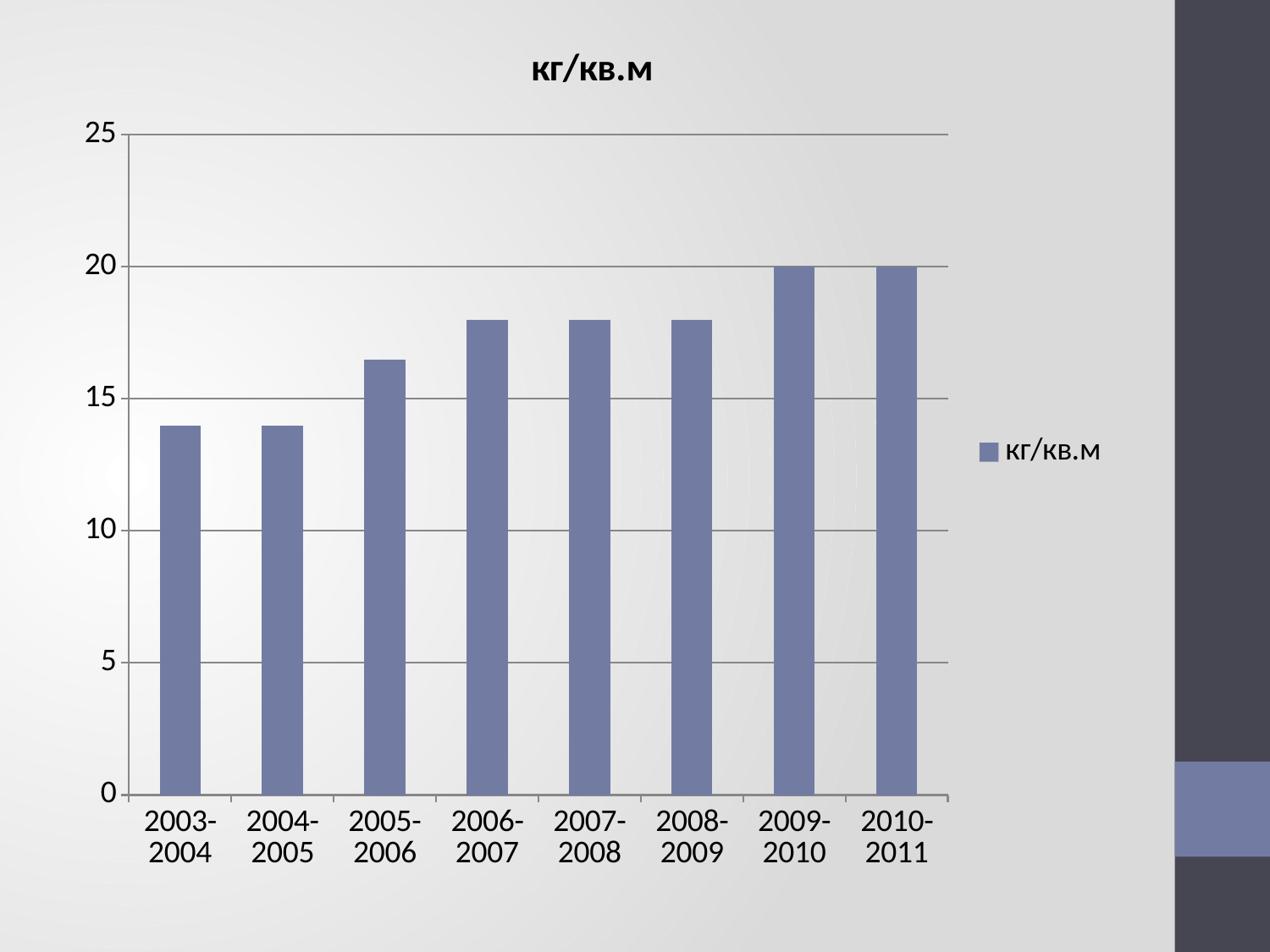
Is the value for 2003-2004 greater or less than 15? less How many series does the legend list? 1 Which is larger, the value for 2007-2008 or the value for 2009-2010? 2009-2010 What is the title of the chart? кг/кв.м What is the value for 2010-2011? 20 Do the values generally rise or fall from 2003-2004 to 2010-2011? rise How many categories (seasons) are shown on the x axis? 8 Is the value for 2006-2007 greater or less than 20? less Is the value for 2005-2006 greater or less than 15? greater What kind of chart is shown on the slide? bar chart Which is larger, the value for 2005-2006 or the value for 2003-2004? 2005-2006 What is the value for 2009-2010? 20